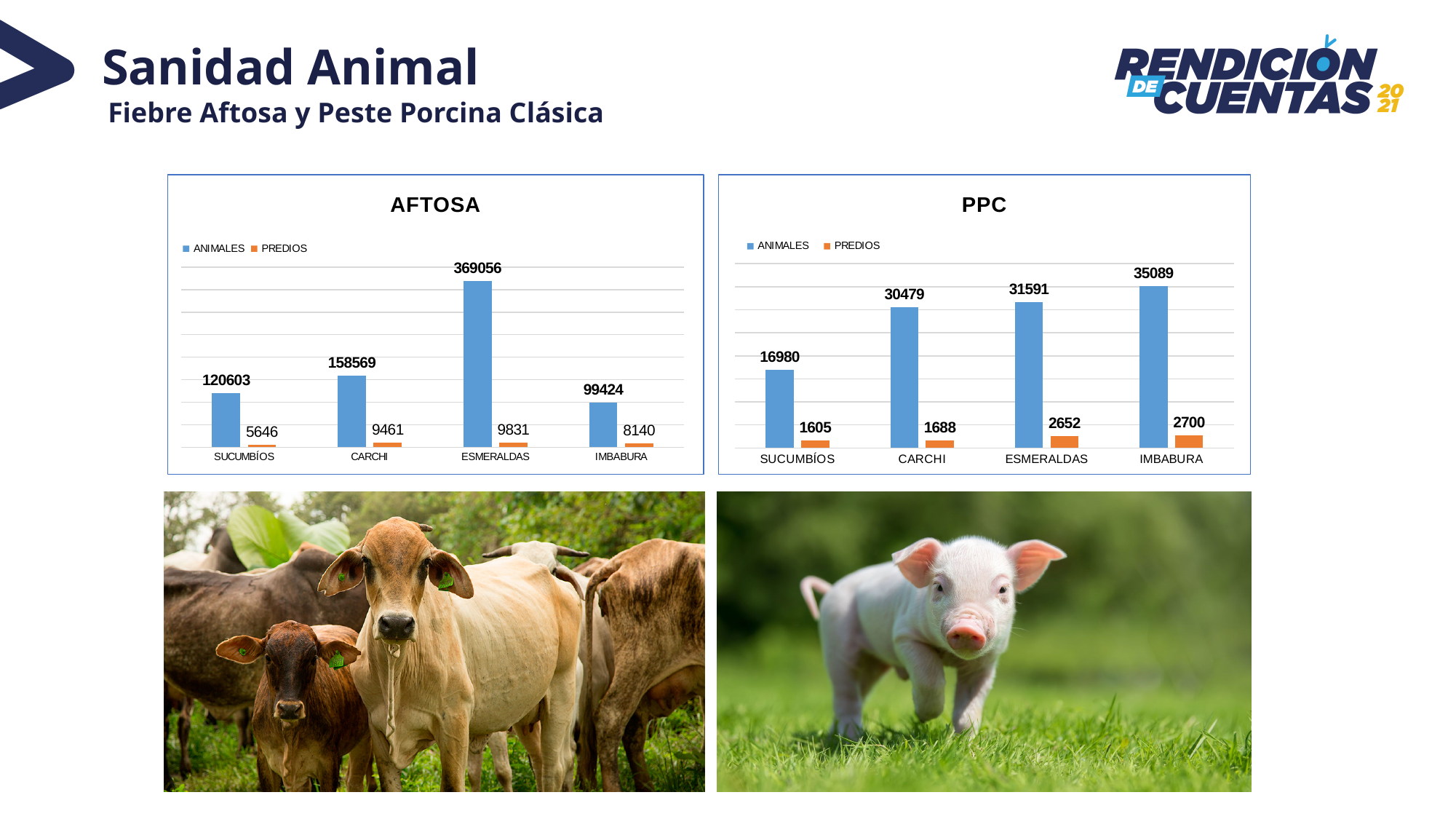
What type of chart is the PPC chart? Bar chart How many series does the legend of the AFTOSA chart list? 2 In the AFTOSA chart, what is the ANIMALES value for ESMERALDAS? 369056 In the AFTOSA chart, which province has the lowest ANIMALES value? IMBABURA In the AFTOSA chart, what is the difference between the ANIMALES values for ESMERALDAS and CARCHI? 210487 In the PPC chart, what is the difference between the PREDIOS values for IMBABURA and SUCUMBÍOS? 1095 How many provinces are shown on the x axis of the PPC chart? 4 In the PPC chart, which province has the highest ANIMALES value? IMBABURA In the AFTOSA chart, which is larger: the PREDIOS value for SUCUMBÍOS or for IMBABURA? IMBABURA In the AFTOSA chart, what is the PREDIOS value for CARCHI? 9461 In the PPC chart, what is the PREDIOS value for IMBABURA? 2700 In the PPC chart, what is the ANIMALES value for SUCUMBÍOS? 16980